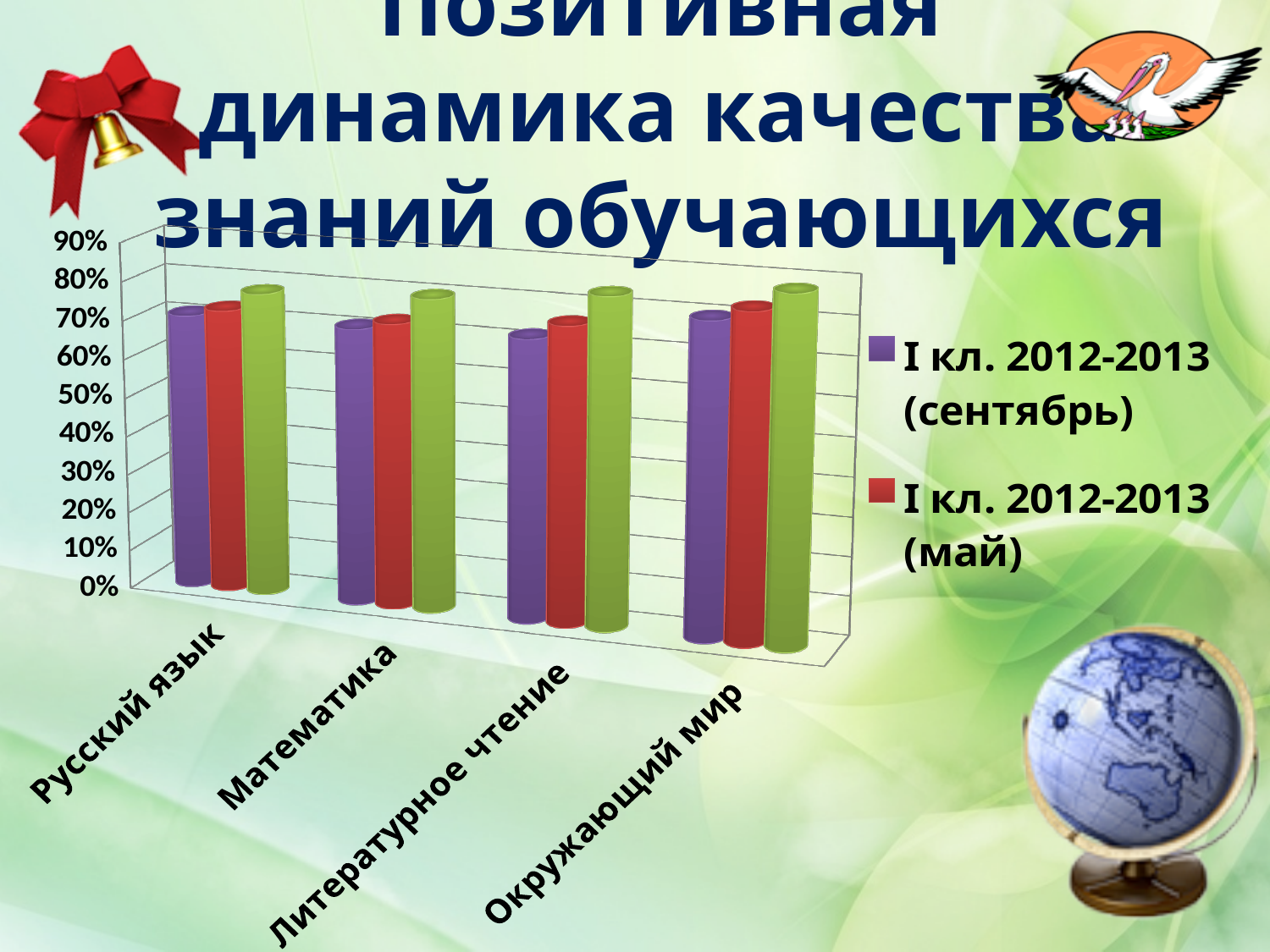
What colour are the bars for the series 'I кл. 2012-2013 (сентябрь)'? purple How many bars are plotted for each subject category? 3 For Литературное чтение, which is larger: the 'I кл. 2012-2013 (сентябрь)' value or the 'I кл. 2012-2013 (май)' value? I кл. 2012-2013 (май) Is the value for Окружающий мир in the 'I кл. 2012-2013 (май)' series greater or less than 90%? less Is the value for Литературное чтение in the 'I кл. 2012-2013 (сентябрь)' series greater or less than 80%? less How many subject categories are shown on the x axis of the chart? 4 What kind of chart is shown on the slide? bar chart Within each subject, do the bars rise or fall from the first (purple) bar to the third (green) bar? rise Which subject is the first category on the x axis? Русский язык For Математика, which is larger: the 'I кл. 2012-2013 (сентябрь)' value or the 'I кл. 2012-2013 (май)' value? I кл. 2012-2013 (май) Is the value for Русский язык in the 'I кл. 2012-2013 (сентябрь)' series greater or less than 50%? greater